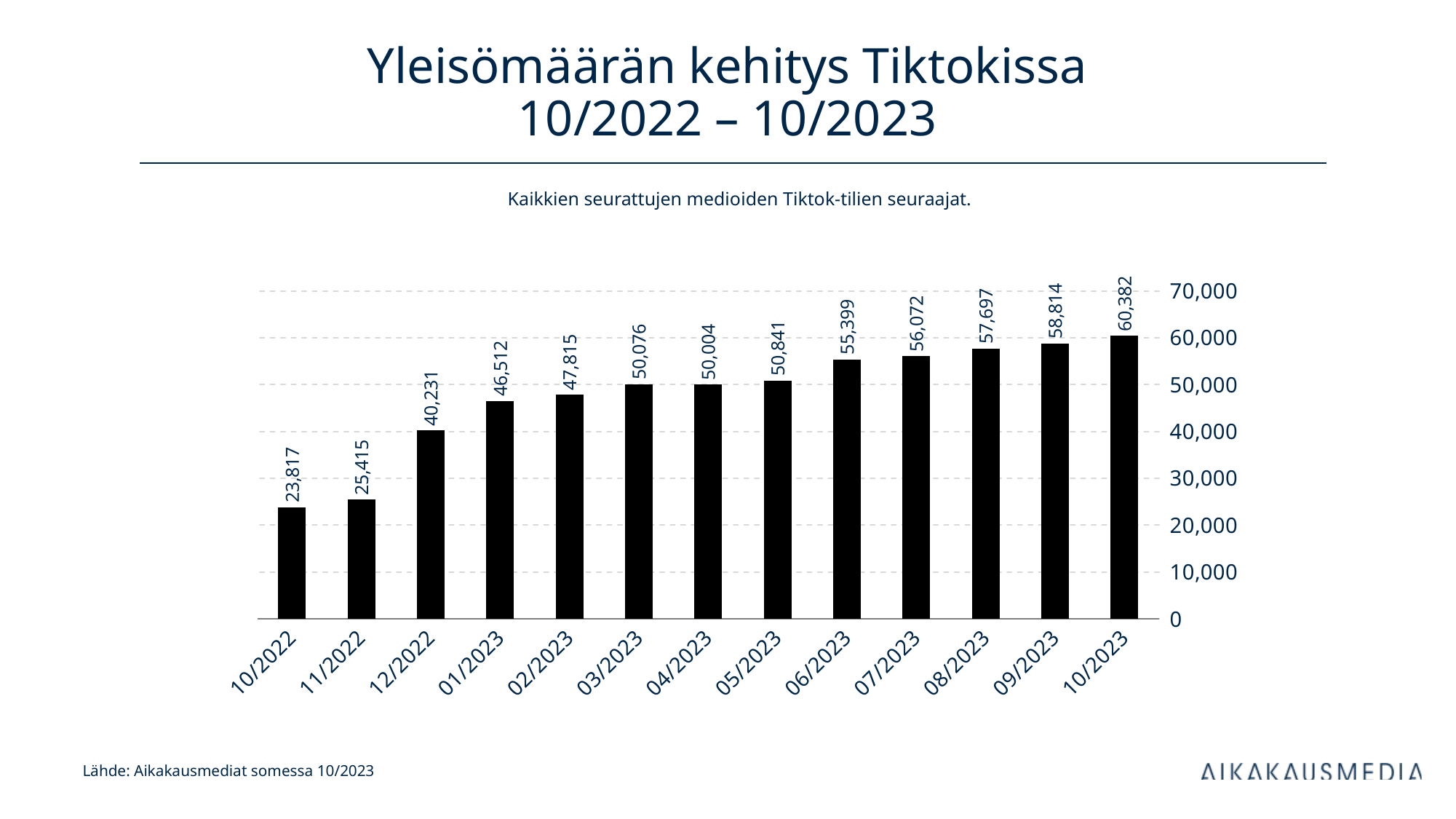
Do the values generally rise or fall from 10/2022 to 10/2023? rise Which month has the highest value? 10/2023 Which is larger, the value for 03/2023 or the value for 04/2023? 03/2023 What is the difference between the values for 10/2023 and 10/2022? 36,565 What kind of chart is shown on the slide? bar chart What is the difference between the values for 12/2022 and 11/2022? 14,816 What is the value for 03/2023? 50,076 What is the value for 10/2022? 23,817 Is the value for 06/2023 greater or less than 50,000? greater How many months are shown on the x axis? 13 Which month has the lowest value? 10/2022 What is the value for 10/2023? 60,382